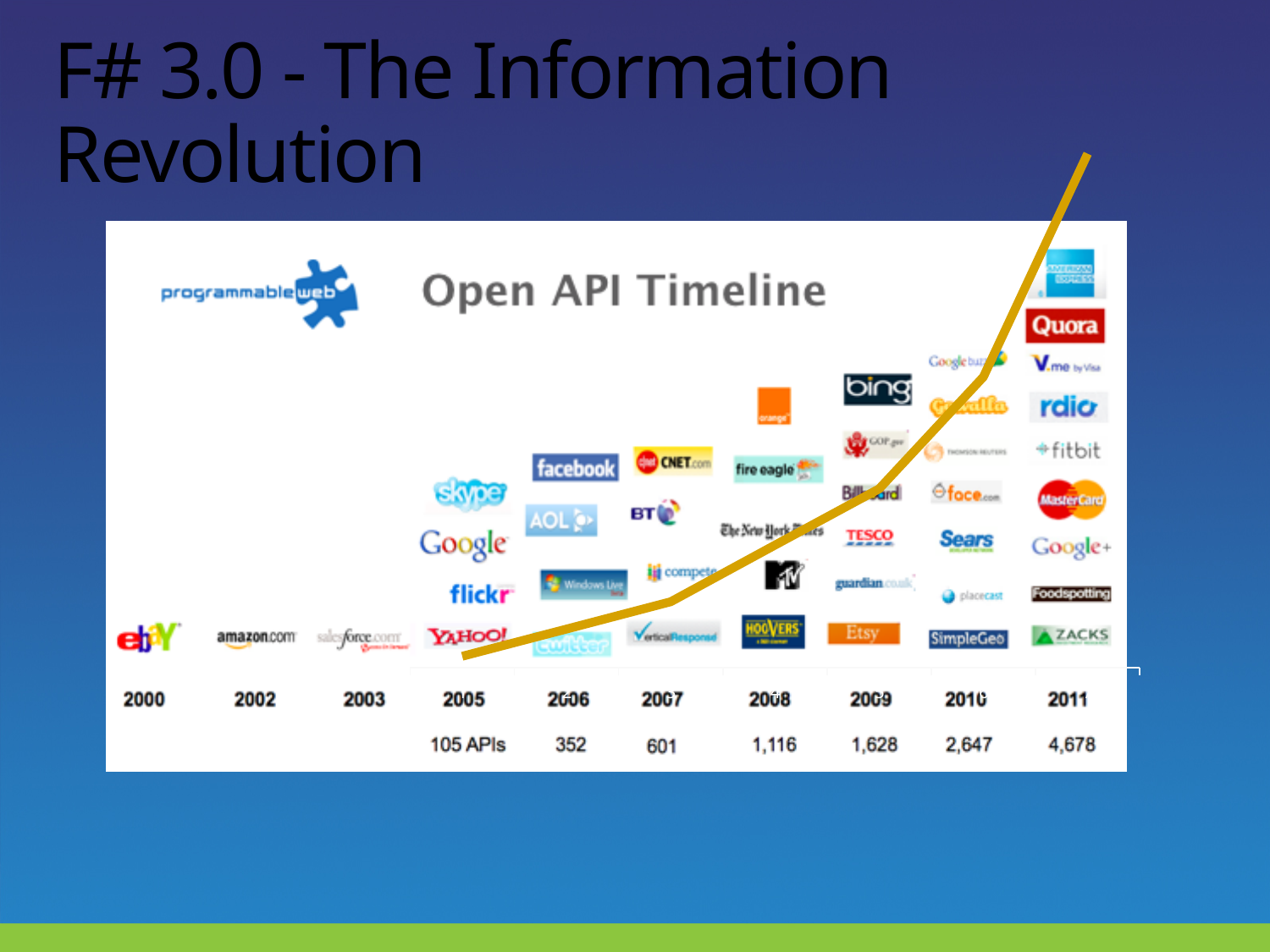
On the Open API Timeline, which year has a larger API count, 2009 or 2008? 2009 What is the API count shown for 2011 on the Open API Timeline? 4,678 On the Open API Timeline, what is the difference between the API counts for 2007 and 2006? 249 What is the API count shown for 2010 on the Open API Timeline? 2,647 On the Open API Timeline, what is the difference between the API counts for 2011 and 2010? 2,031 What is the API count shown for 2008 on the Open API Timeline? 1,116 Do the API counts on the Open API Timeline rise or fall from 2005 to 2011? rise What is the title of the timeline graphic on the slide? Open API Timeline Which year on the Open API Timeline has the highest API count? 2011 Which year on the Open API Timeline has the lowest printed API count? 2005 How many APIs are listed for 2005 on the Open API Timeline? 105 APIs How many years are labelled along the bottom of the Open API Timeline? 10